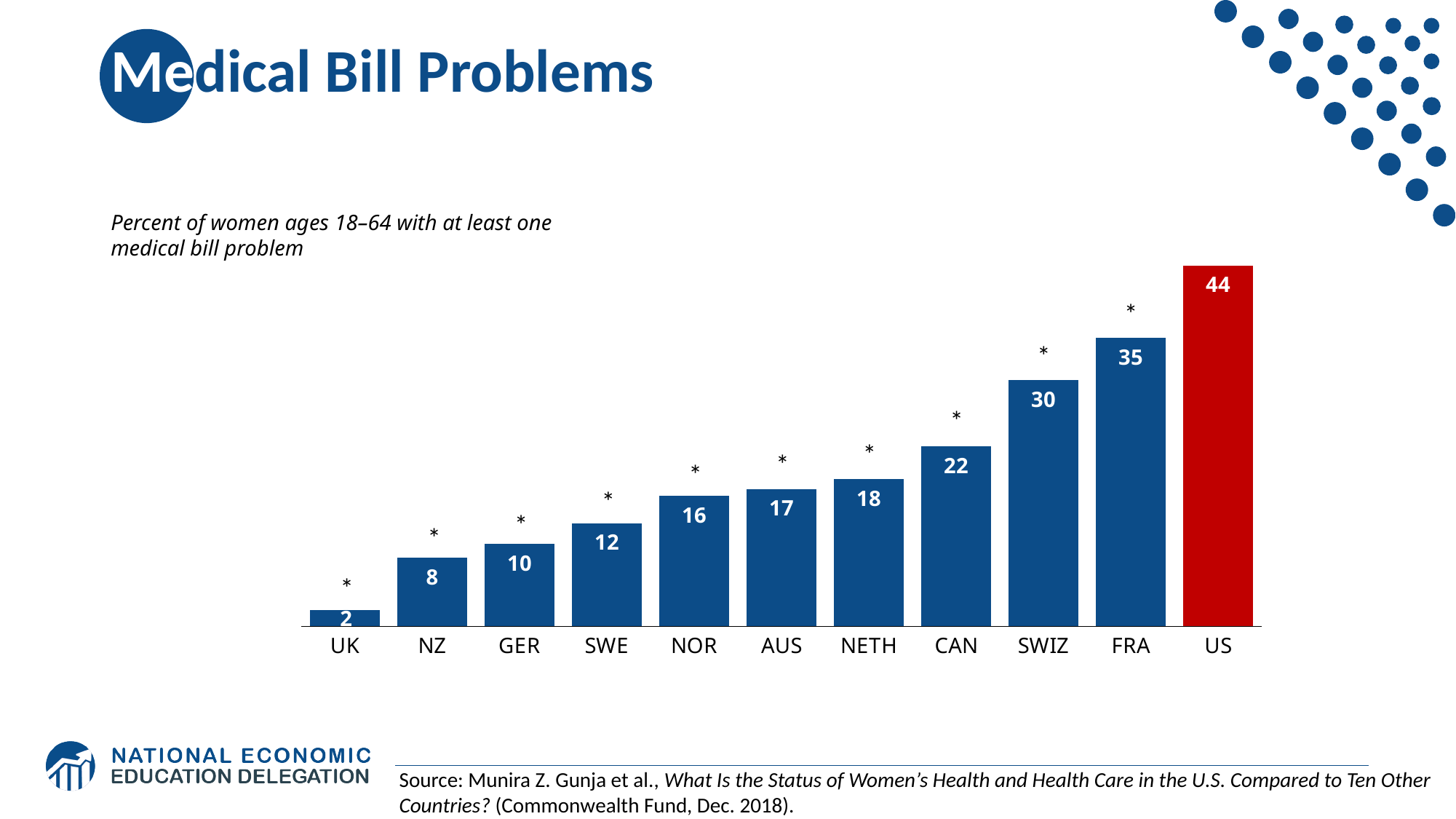
Which has a larger value, Norway (NOR) or Sweden (SWE)? NOR Which country has the lowest value? UK Do the values rise or fall from left to right along the x axis? Rise What is the value for the US? 44 What is the value for Canada (CAN)? 22 What is the difference between the values for the US and France (FRA)? 9 What is the difference between the values for Switzerland (SWIZ) and the UK? 28 Which country's bar is coloured red rather than blue? US How many countries are shown in the chart? 11 Which country has the highest value? US What is the value for Germany (GER)? 10 What kind of chart is shown on the slide? Bar chart